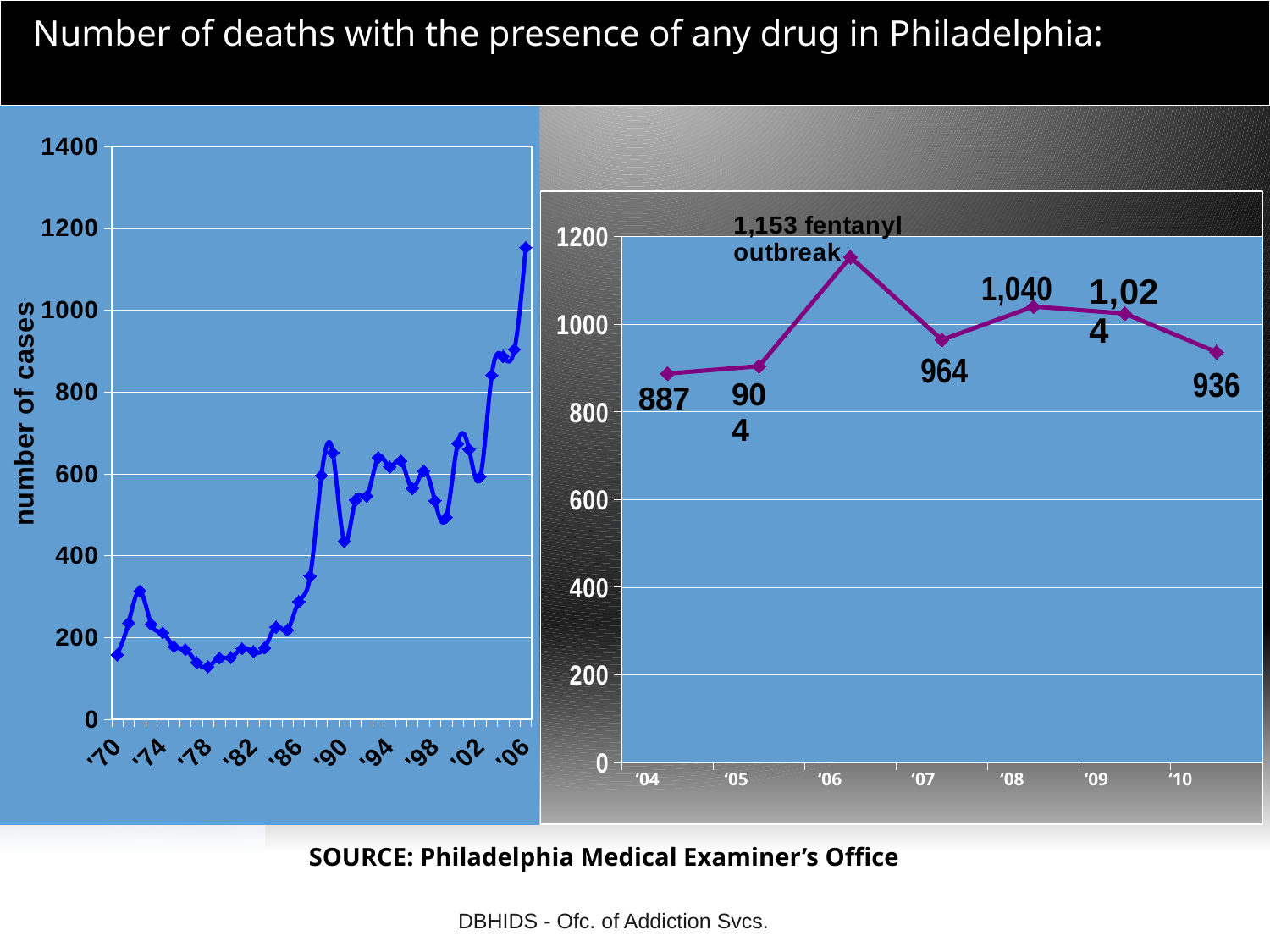
In the left-hand chart (1970–2006), is the value for '78 greater or less than 200? less In the left-hand chart (1970–2006), is the value for '06 greater or less than 1000? greater In the right-hand chart (2004–2010), which is larger, the value for '05 or the value for '07? '07 In the right-hand chart (2004–2010), what event is annotated at the '06 peak? fentanyl outbreak In the right-hand chart (2004–2010), what is the difference between the values for '06 and '07? 189 In the right-hand chart (2004–2010), what is the value for '04? 887 In the right-hand chart (2004–2010), what is the value for '10? 936 In the right-hand chart (2004–2010), which year has the highest value? '06 In the right-hand chart (2004–2010), which year has the lowest value? '04 In the right-hand chart (2004–2010), what is the difference between the values for '08 and '10? 104 In the right-hand chart (2004–2010), how many data points are plotted? 7 In the right-hand chart (2004–2010), what is the value for '08? 1,040